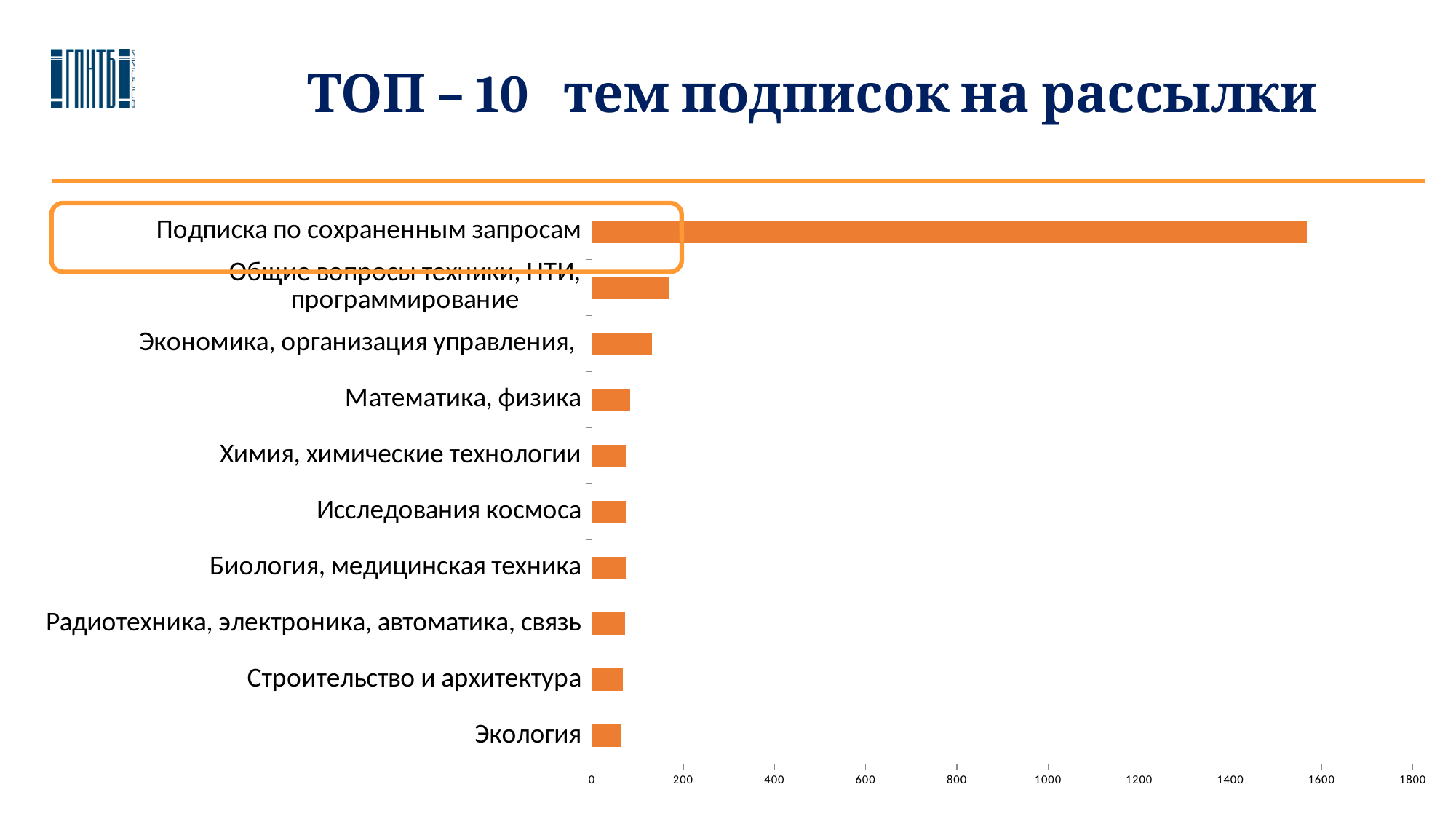
Which is larger: the value for Подписка по сохраненным запросам or the value for Общие вопросы техники, НТИ, программирование? Подписка по сохраненным запросам Is the value for Экономика, организация управления, greater or less than 200? less What is the title of the slide above the chart? ТОП – 10 тем подписок на рассылки Which is larger: the value for Общие вопросы техники, НТИ, программирование or the value for Экономика, организация управления,? Общие вопросы техники, НТИ, программирование Which category has the highest value in the chart? Подписка по сохраненным запросам How many categories (topics) are plotted in the chart? 10 Is the value for Общие вопросы техники, НТИ, программирование greater or less than 200? less Is the value for Подписка по сохраненным запросам greater or less than 1600? less What kind of chart is shown on the slide? bar chart Do the bar values rise or fall going from the top category to the bottom category? fall